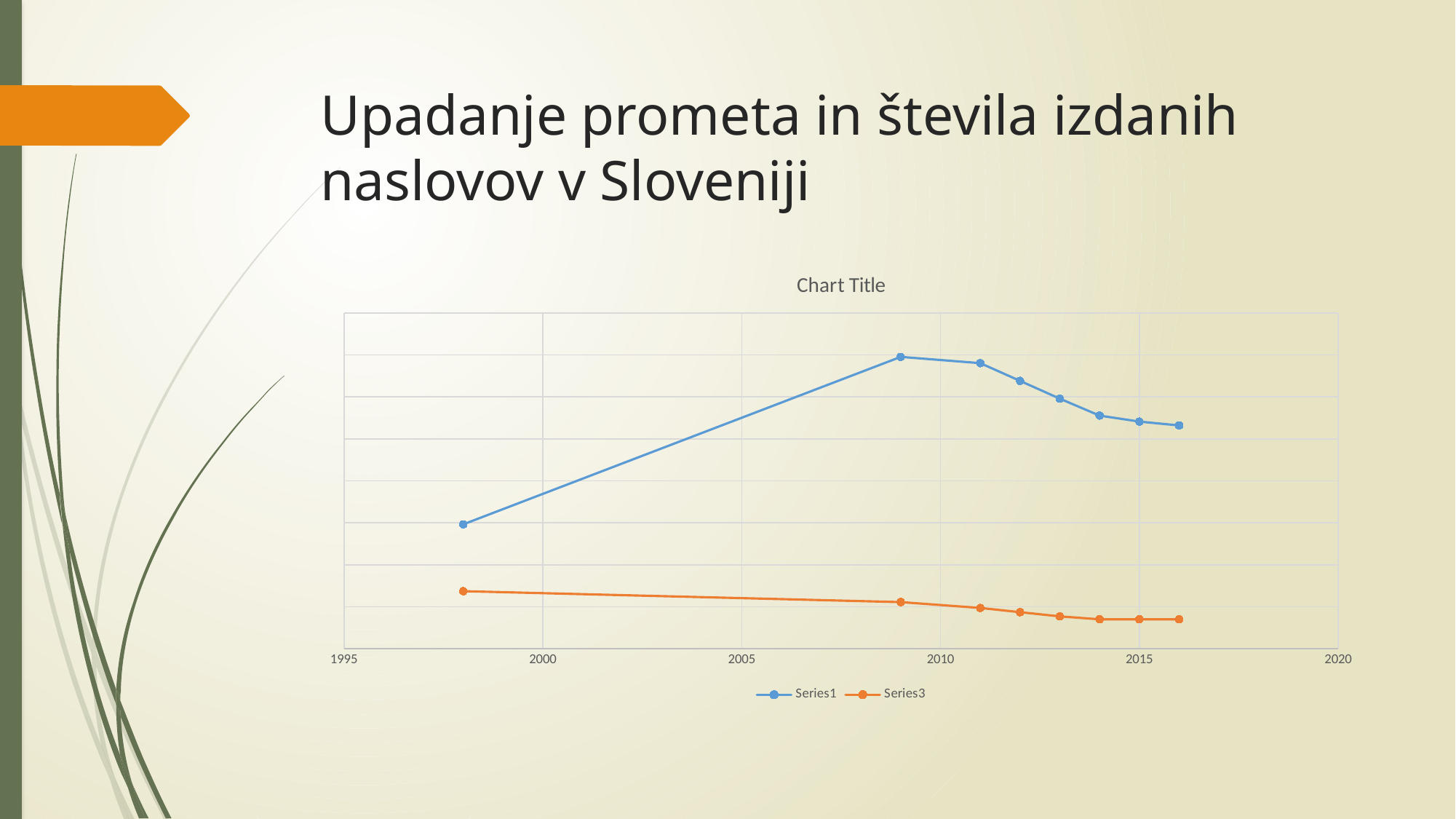
What is the title shown above the chart? Chart Title In which year does Series3 have its highest value? 1998 How many series does the chart legend list? 2 What are the names of the series listed in the legend? Series1 and Series3 Which series has the higher value in 2016, Series1 or Series3? Series1 In which year does Series1 reach its highest value? 2009 Does Series1 rise or fall between 2009 and 2016? fall What kind of chart is shown on the slide? line chart Does Series3 rise or fall from 1998 to 2016? fall Does Series1 rise or fall between 1998 and 2009? rise In which year does Series1 have its lowest value? 1998 How many data points are plotted for Series1? 8